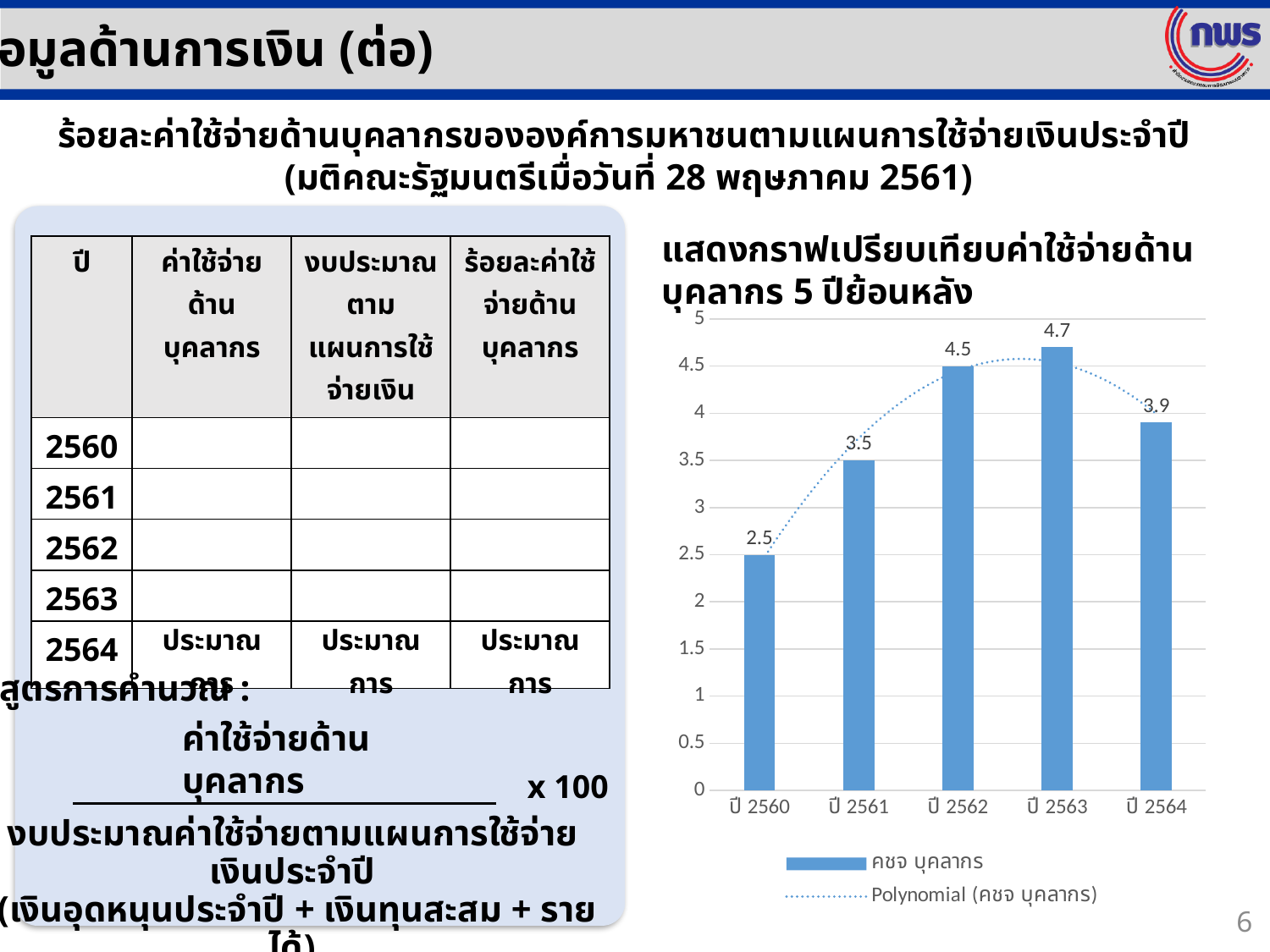
What kind of chart is shown? bar chart Which year has the highest value? ปี 2563 Which is larger, the value for ปี 2562 or the value for ปี 2564? ปี 2562 How many entries does the legend list? 2 What is the difference between the values for ปี 2562 and ปี 2561? 1 What is the value for ปี 2560? 2.5 Is the value for ปี 2561 greater or less than 3? greater What is the value for ปี 2564? 3.9 How many years are shown on the x axis? 5 What is the value for ปี 2563? 4.7 What is the difference between the values for ปี 2563 and ปี 2564? 0.8 Which year has the lowest value? ปี 2560